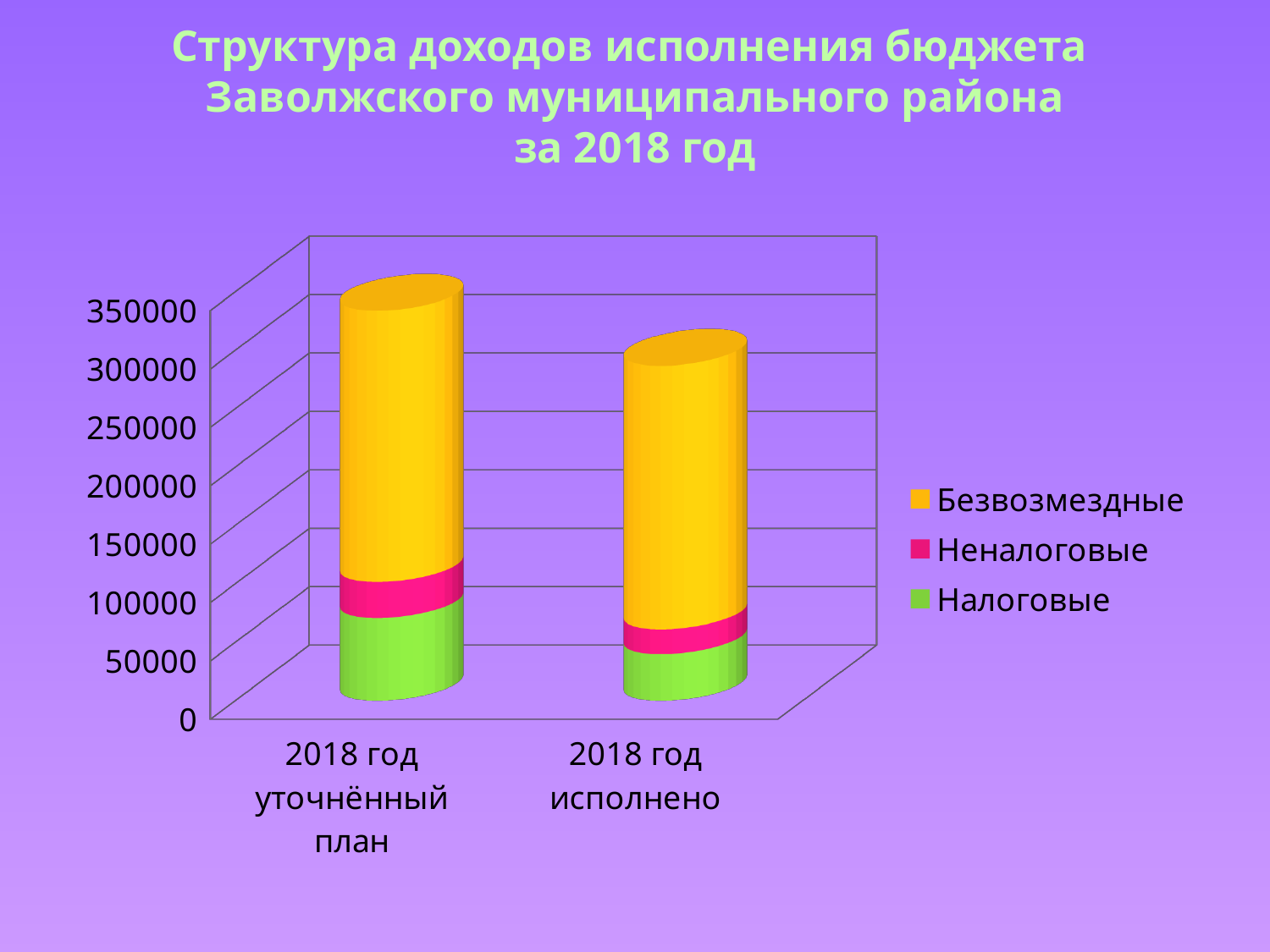
What kind of chart is shown on the slide? bar chart Is the total for "2018 год уточнённый план" greater or less than 250000? greater How many series does the legend list? 3 Is the "Налоговые" segment larger in "2018 год уточнённый план" or in "2018 год исполнено"? 2018 год уточнённый план How many categories are shown on the x axis? 2 Which series makes up the largest part of each bar? Безвозмездные Which bar is taller overall: "2018 год уточнённый план" or "2018 год исполнено"? 2018 год уточнённый план Which series makes up the smallest part of the "2018 год исполнено" bar? Неналоговые Which year does the chart title refer to? 2018 Is the total for "2018 год исполнено" greater or less than 200000? greater Which colour represents the "Налоговые" series in the legend? green Is the total for "2018 год исполнено" greater or less than 350000? less